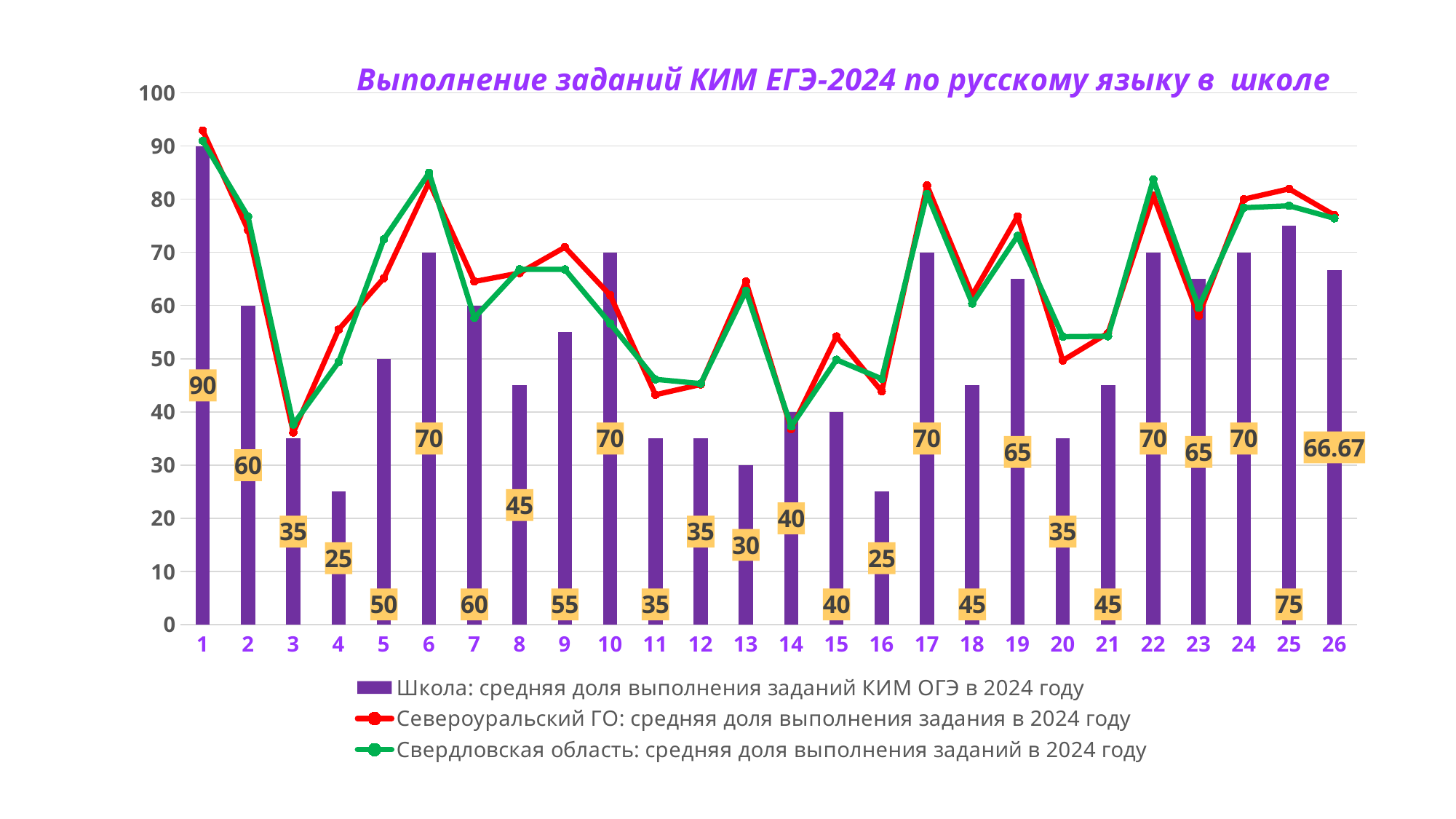
Is the value of the Свердловская область line for task 6 greater or less than 80? greater Which school bar is larger: task 19 or task 9? task 19 How many series does the legend list? 3 What is the value of the school bar for task 13? 30 What is the lowest school bar value shown on the chart? 25 What is the value of the school bar for task 1? 90 Which task has the highest school bar value? 1 What kind of chart is this? Combined bar and line chart What is the value of the school bar for task 26? 66.67 Is the value of the Североуральский ГО line for task 3 greater or less than 40? less What is the difference between the school bar values for task 25 and task 3? 40 How many tasks are shown on the x axis? 26